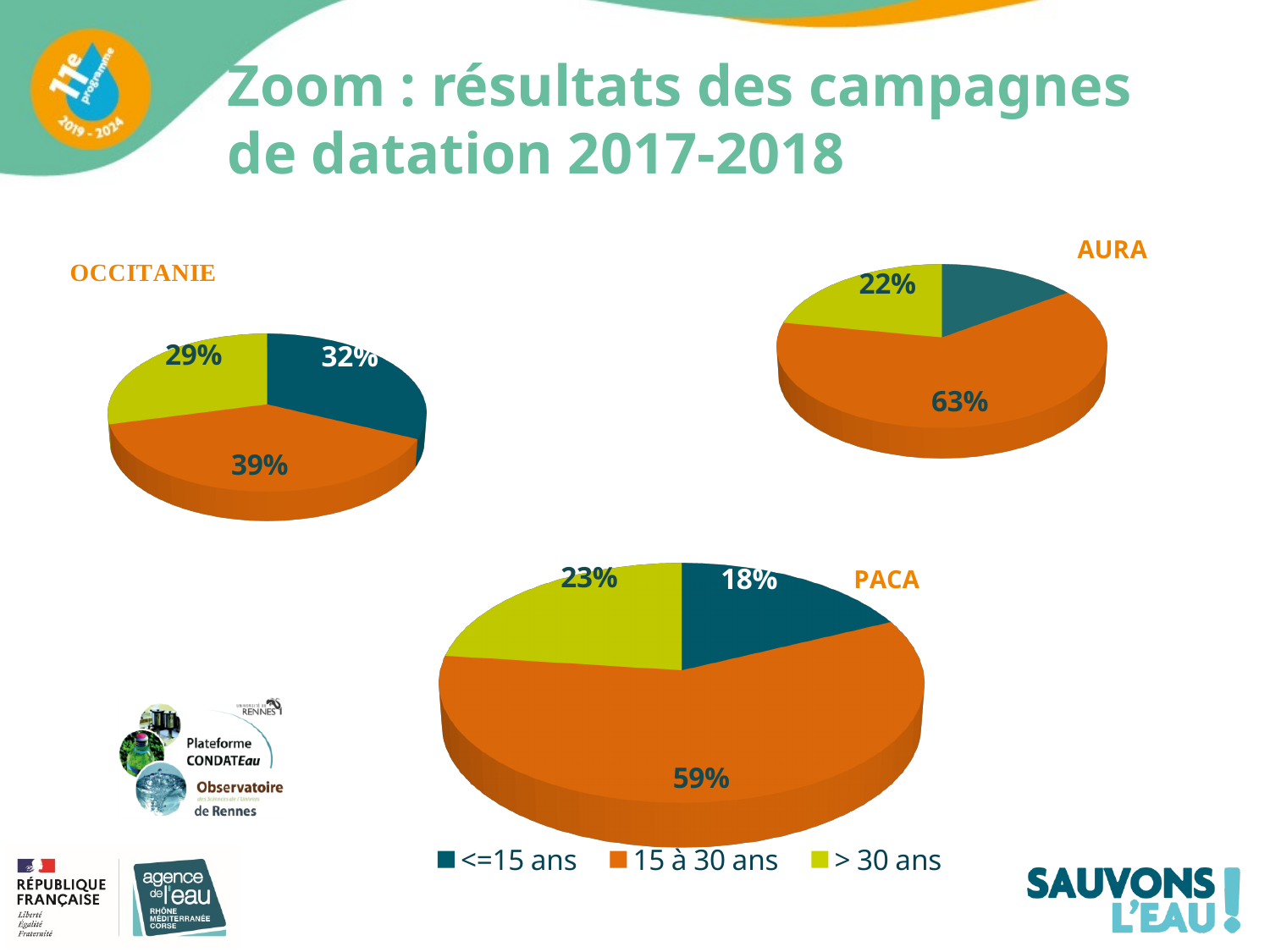
In the PACA pie chart, which category has the largest share? 15 à 30 ans Which is larger: the '<=15 ans' share in the OCCITANIE chart or the '<=15 ans' share in the PACA chart? OCCITANIE In the OCCITANIE pie chart, what share is shown for the '15 à 30 ans' category? 39% In the PACA pie chart, what share is shown for the '<=15 ans' category? 18% How many categories does the legend list for the pie charts? 3 In the PACA pie chart, what is the difference between the '15 à 30 ans' share and the '> 30 ans' share? 36% In the AURA pie chart, what share is shown for the '> 30 ans' category? 22% In the AURA pie chart, what share is shown for the '15 à 30 ans' category? 63% In the OCCITANIE pie chart, which category has the smallest share? > 30 ans In the OCCITANIE pie chart, what share is shown for the '<=15 ans' category? 32% What type of chart is used for the OCCITANIE, AURA and PACA data? Pie chart Which colour represents the '> 30 ans' category in the legend? Yellow-green